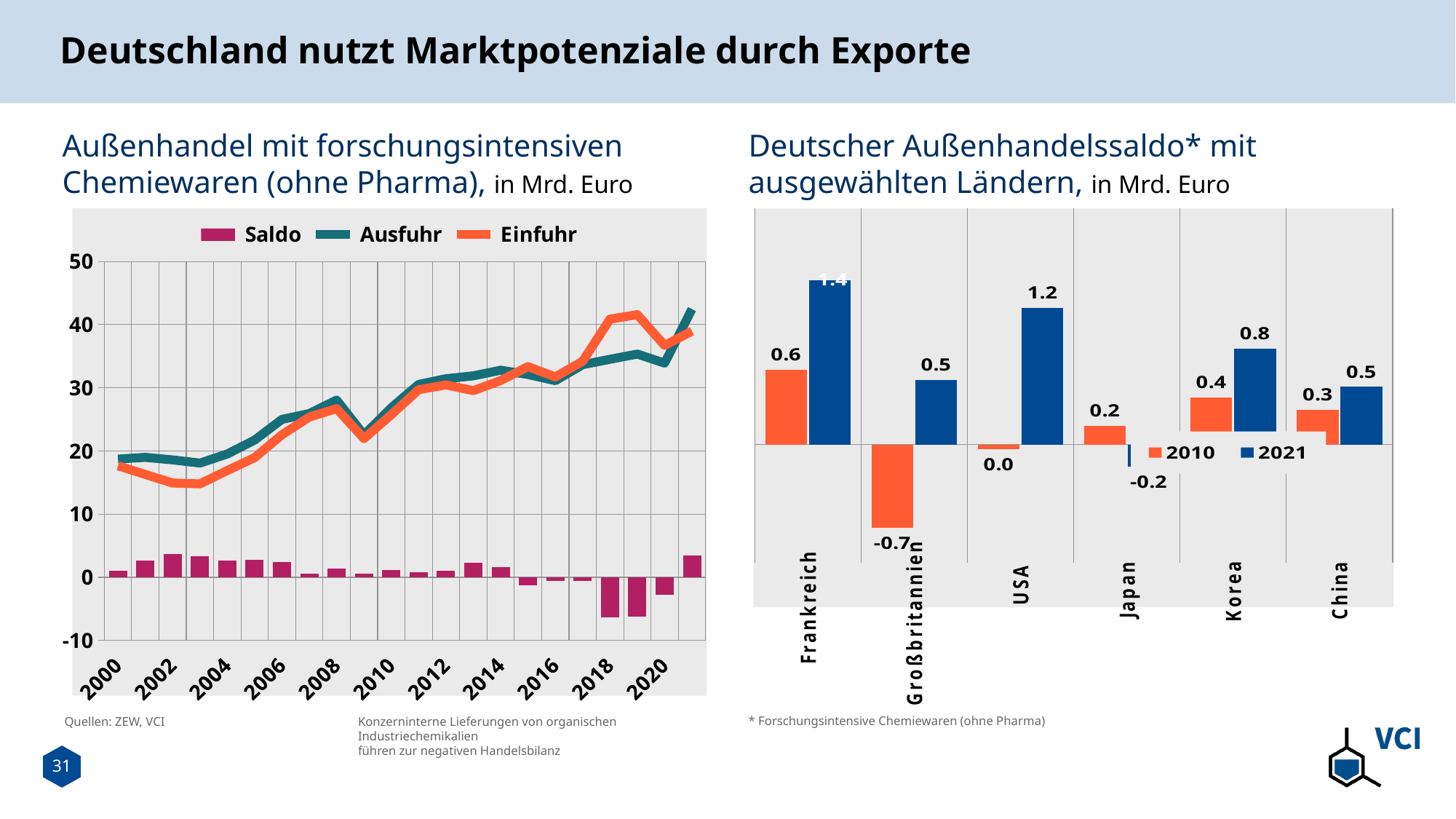
What kind of chart is the chart 'Deutscher Außenhandelssaldo mit ausgewählten Ländern'? bar chart In the chart 'Deutscher Außenhandelssaldo mit ausgewählten Ländern', which country has the lowest 2010 value? Großbritannien In the chart 'Deutscher Außenhandelssaldo mit ausgewählten Ländern', what is the 2010 value for Großbritannien? -0.7 How many series does the legend of the chart 'Deutscher Außenhandelssaldo mit ausgewählten Ländern' list? 2 In the chart 'Deutscher Außenhandelssaldo mit ausgewählten Ländern', what is the 2021 value for Frankreich? 1.4 How many series does the legend of the chart 'Außenhandel mit forschungsintensiven Chemiewaren (ohne Pharma)' list? 3 How many countries are shown in the chart 'Deutscher Außenhandelssaldo mit ausgewählten Ländern'? 6 In the chart 'Deutscher Außenhandelssaldo mit ausgewählten Ländern', by how much did the value for USA increase from 2010 to 2021? 1.2 In the chart 'Deutscher Außenhandelssaldo mit ausgewählten Ländern', which country has the highest 2021 value? Frankreich In the chart 'Außenhandel mit forschungsintensiven Chemiewaren (ohne Pharma)', is the Einfuhr value for 2002 greater or less than 20? less In the chart 'Außenhandel mit forschungsintensiven Chemiewaren (ohne Pharma)', is the Ausfuhr value for 2021 greater or less than 40? greater In the chart 'Deutscher Außenhandelssaldo mit ausgewählten Ländern', which is larger: the 2021 value for Korea or the 2021 value for China? Korea